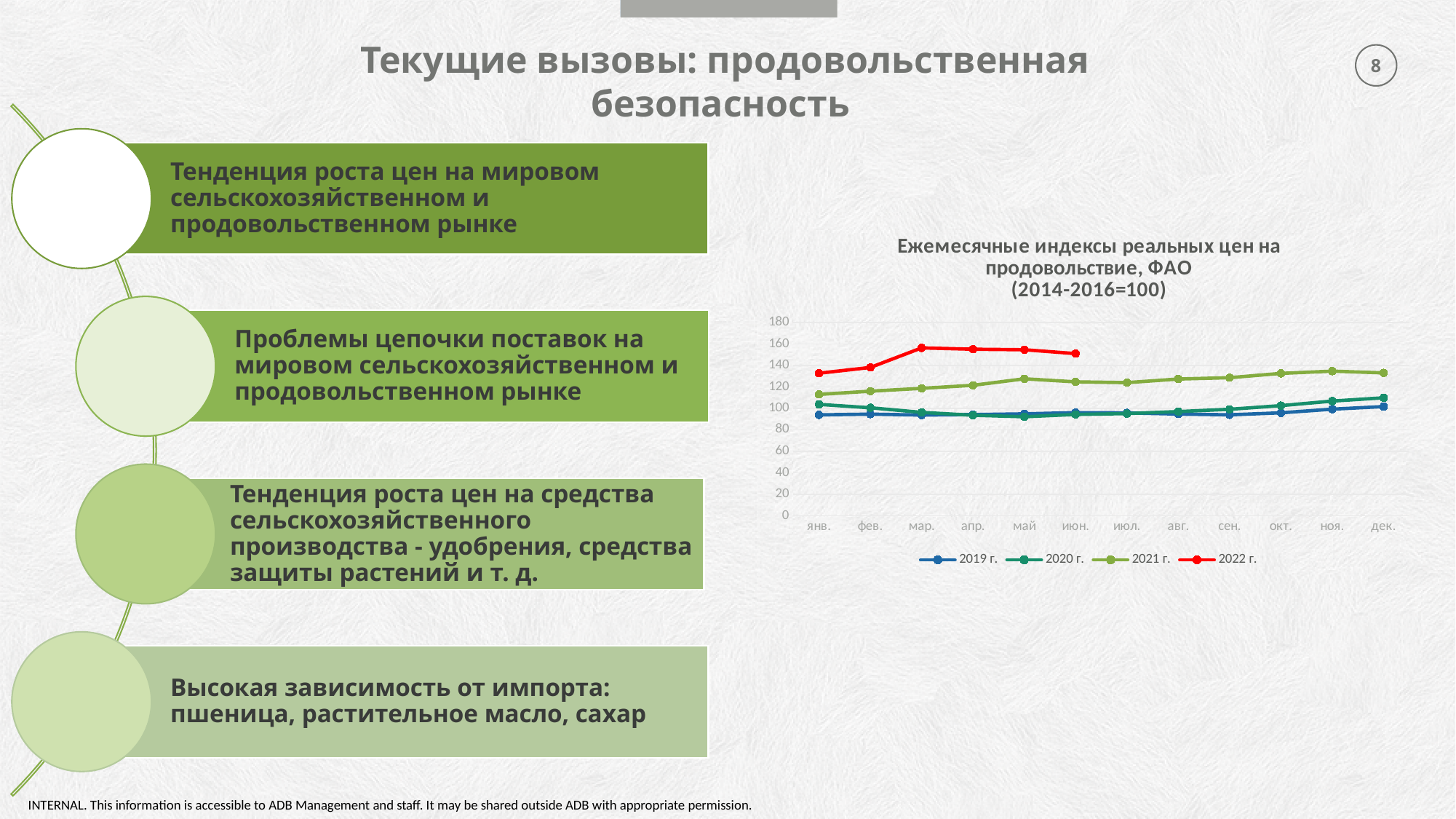
How many months are shown on the x axis of the chart? 12 Which is larger in дек., the value for 2021 г. or for 2019 г.? 2021 г. Does the 2021 г. series generally rise or fall from янв. to дек.? rise Which series has the highest value in мар.? 2022 г. What kind of chart is shown on the slide? line chart Is the value for 2020 г. in дек. greater or less than 100? greater How many series does the chart legend list? 4 How many data points does the 2022 г. series have? 6 What colour is the line for the 2022 г. series? red Is the value for 2021 г. in янв. greater or less than 120? less Is the value for 2022 г. in мар. greater or less than 140? greater